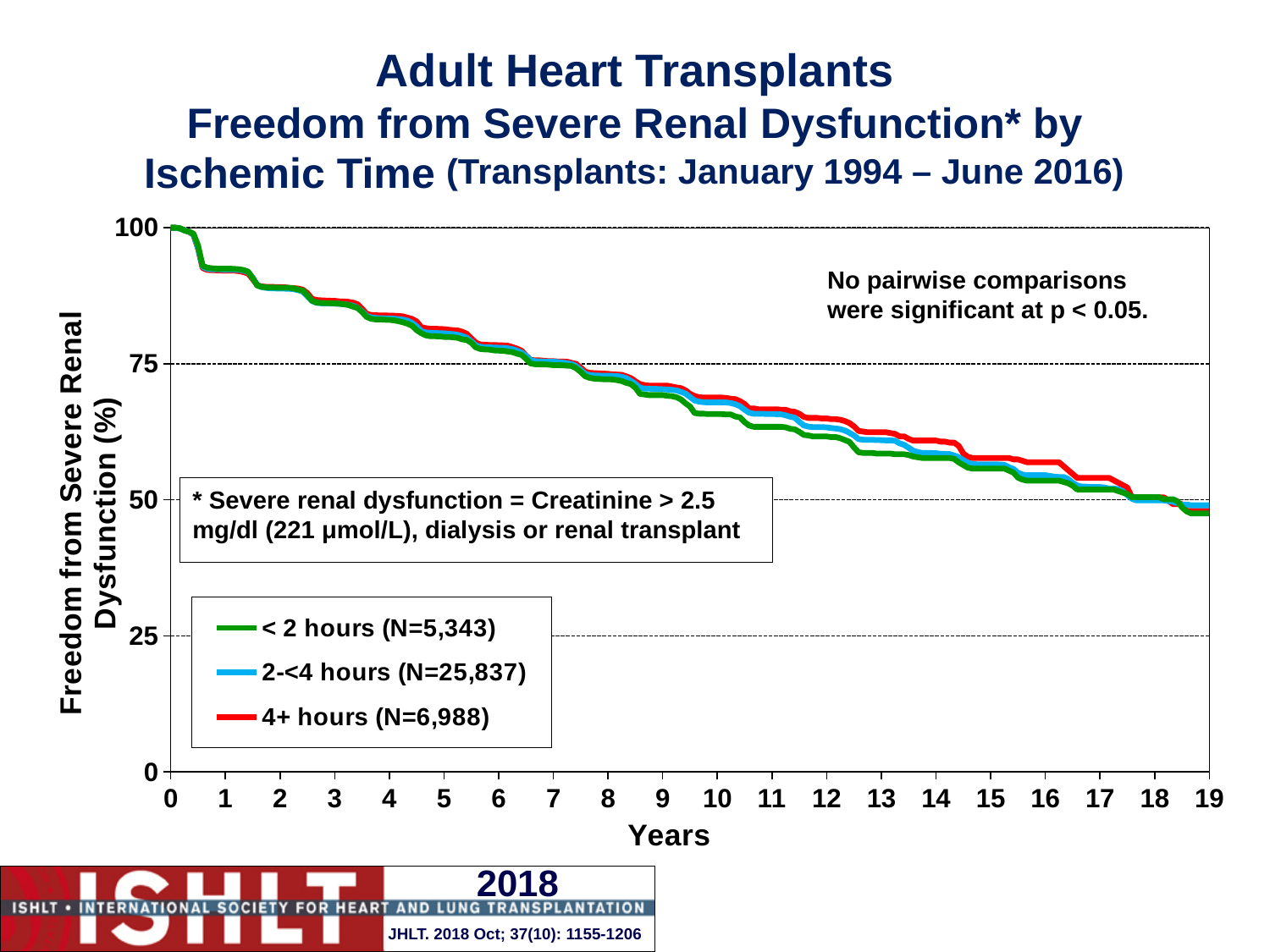
At year 12, which series has the higher value: 4+ hours or < 2 hours? 4+ hours Is the value for the 4+ hours series at year 5 greater or less than 75? greater What kind of chart is shown on the slide? line chart Is the value for the 2-<4 hours series at year 15 greater or less than 50? greater What is the label of the x axis? Years Is the value for the < 2 hours series at year 10 greater or less than 75? less According to the legend, what is the N for the 2-<4 hours series? N=25,837 What is the freedom from severe renal dysfunction for all three series at year 0? 100 Do the values for the < 2 hours series rise or fall as years increase? fall How many series does the legend list? 3